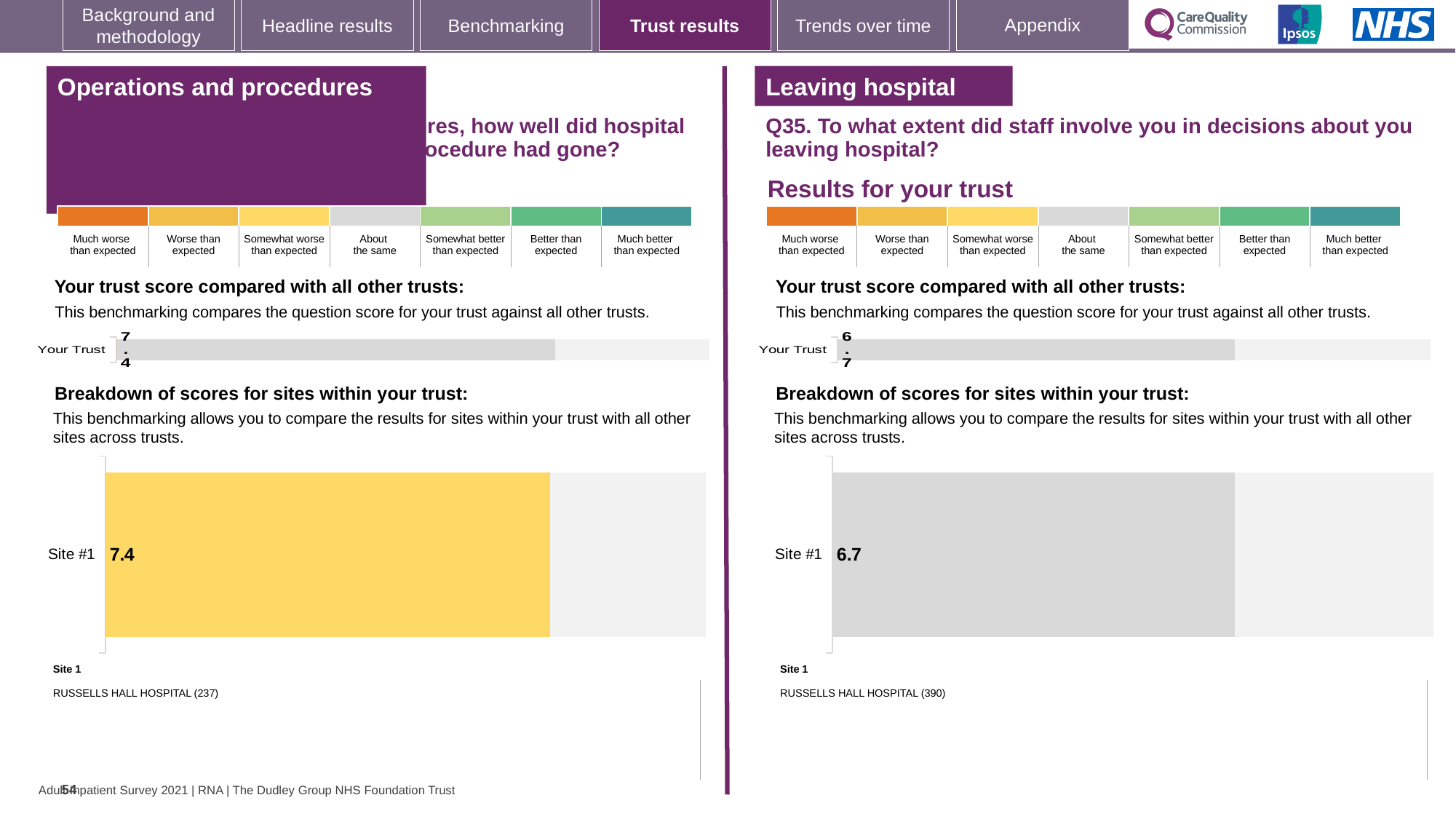
Which site name is listed as Site 1 below the breakdown chart in the Leaving hospital section? RUSSELLS HALL HOSPITAL (390) What is the difference between the Site #1 score in the Operations and procedures section (7.4) and the Site #1 score in the Leaving hospital section (6.7)? 0.7 In the Leaving hospital section, what colour is the Site #1 bar in the breakdown chart? Grey In the Leaving hospital section, what is the score shown for Your Trust in the 'Your trust score compared with all other trusts' chart? 6.7 Which site name is listed as Site 1 below the breakdown chart in the Operations and procedures section? RUSSELLS HALL HOSPITAL (237) What type of chart is used to show the Site #1 score in the Operations and procedures section? Bar chart In the Operations and procedures section, what is the score shown for Your Trust in the 'Your trust score compared with all other trusts' chart? 7.4 Which is larger: the Site #1 score in the Operations and procedures section or the Site #1 score in the Leaving hospital section? Operations and procedures In the Operations and procedures section, what colour is the Site #1 bar in the breakdown chart? Yellow In the Leaving hospital section, what score is shown for Site #1 in the 'Breakdown of scores for sites within your trust' chart? 6.7 How many sites are shown in the 'Breakdown of scores for sites within your trust' chart in the Leaving hospital section? 1 In the Operations and procedures section, what score is shown for Site #1 in the 'Breakdown of scores for sites within your trust' chart? 7.4